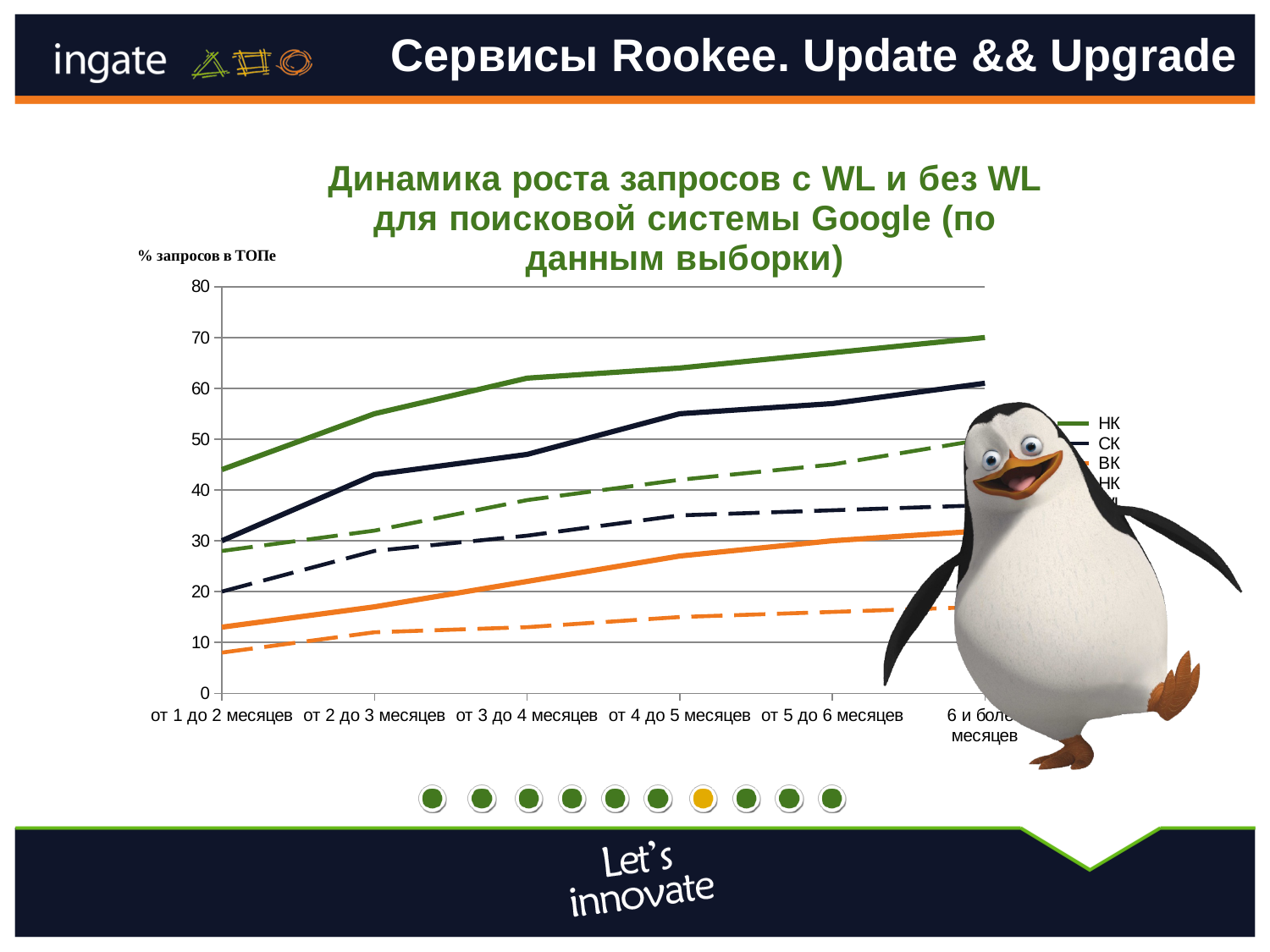
At 'от 3 до 4 месяцев', which is larger: the solid dark СК line or the dashed green line? solid dark СК line What is the label of the vertical axis of the chart? % запросов в ТОПе How many categories are shown along the x axis of the chart? 6 Is the value of the solid orange ВК line at 'от 1 до 2 месяцев' greater or less than 20? less Does the solid green НК line rise or fall from left to right across the x axis? rises Does the solid orange ВК line rise or fall from left to right across the x axis? rises Which line has the lowest value at the category 'от 5 до 6 месяцев'? dashed orange Is the value of the solid green НК line at 'от 1 до 2 месяцев' greater or less than 40? greater What is the label of the first category on the x axis? от 1 до 2 месяцев What kind of chart is shown on the slide? line chart Is the value of the solid dark СК line at 'от 5 до 6 месяцев' greater or less than 50? greater Which line has the highest value at the category 'от 1 до 2 месяцев'? solid green НК